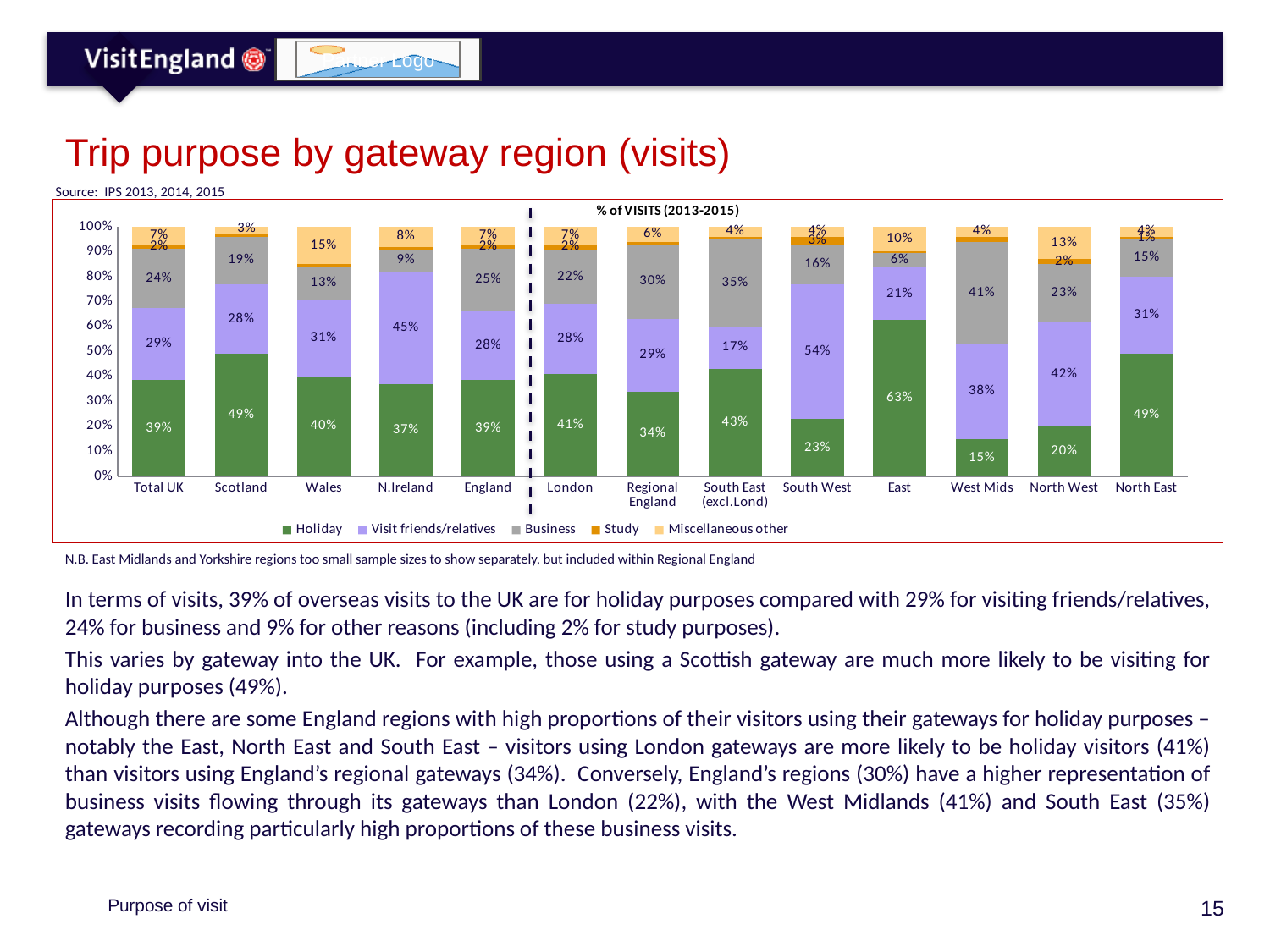
What is the Miscellaneous other share for Wales? 15% How many gateway regions (categories) are shown along the x axis? 13 What is the Holiday share for Scotland? 49% What is the difference between the Holiday share for London and for Regional England? 7 percentage points Which has a larger Business share, London or Regional England? Regional England What is the Business share for West Mids? 41% What is the Visit friends/relatives share for South West? 54% How many series does the legend list? 5 Which gateway region has the lowest Holiday share? West Mids What kind of chart is shown on the slide? Stacked bar chart What is the title shown above the chart? % of VISITS (2013-2015) Which gateway region has the highest Holiday share? East